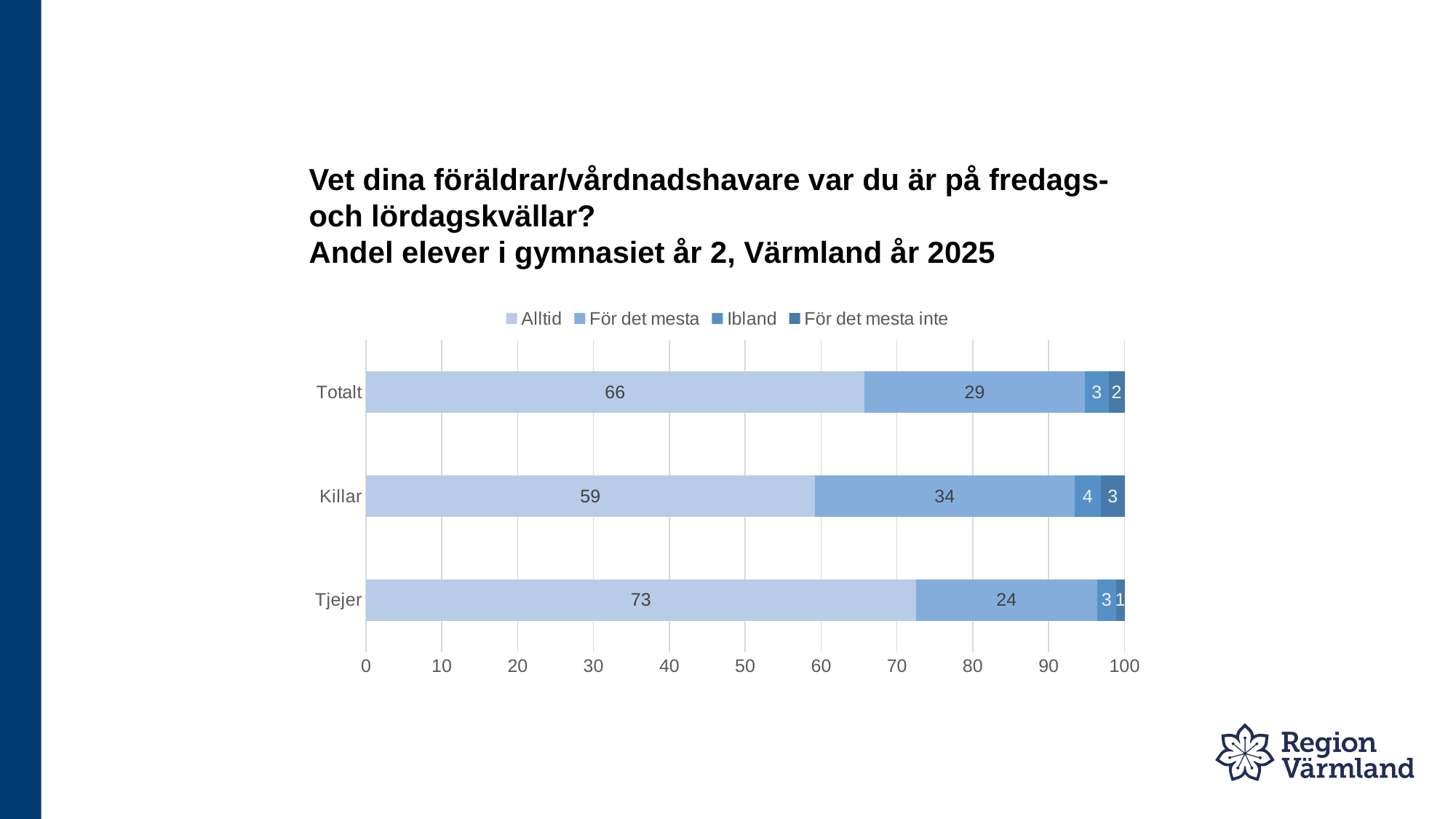
What is the value of "Alltid" for Totalt? 66 What is the value of "Ibland" for Tjejer? 3 What is the value of "För det mesta inte" for Killar? 3 What kind of chart is shown on the slide? Stacked bar chart What is the total of the stacked bar for Totalt? 100 How many categories are shown on the y axis? 3 Which category has the lowest value for "Alltid"? Killar Which category has the highest value for "Alltid"? Tjejer How many series does the legend list? 4 Which is larger: the "För det mesta" value for Killar or for Tjejer? Killar What is the value of "För det mesta" for Killar? 34 What is the difference between the "Alltid" values for Tjejer and Killar? 14